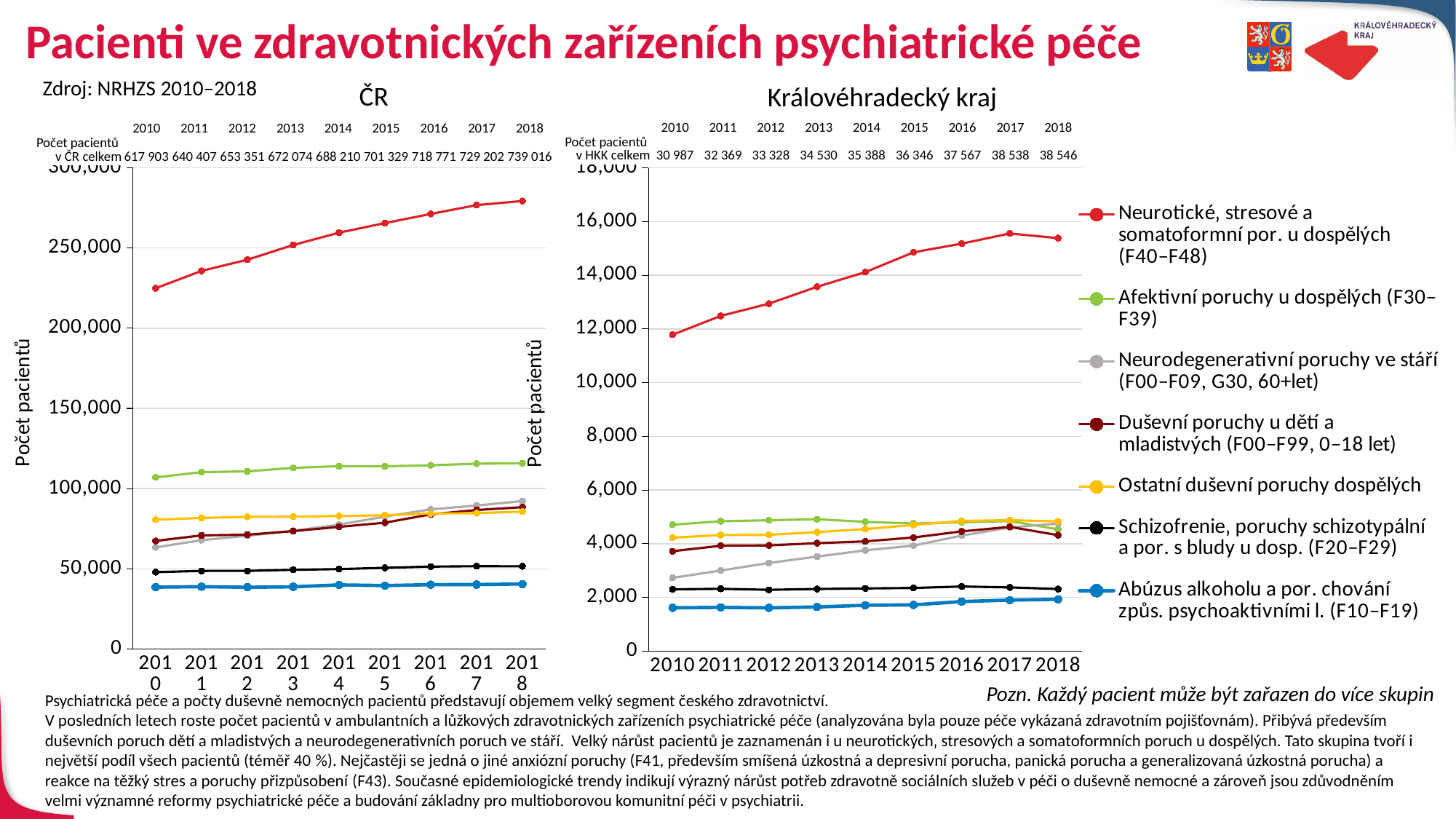
In the Královéhradecký kraj chart, which series has the lowest value in 2018? Abúzus alkoholu a por. chování způs. psychoaktivními l. (F10–F19) How many series does the legend list for the charts? 7 In the ČR chart, does the Neurotické, stresové a somatoformní por. u dospělých (F40–F48) series rise or fall from 2010 to 2018? rise In the Královéhradecký kraj chart, is the 2017 value for Neurotické, stresové a somatoformní por. u dospělých (F40–F48) greater or less than 14,000? greater In the Královéhradecký kraj chart, does the Neurodegenerativní poruchy ve stáří (F00–F09, G30, 60+let) series rise or fall from 2010 to 2018? rise In the Královéhradecký kraj chart, which series has the highest value in 2018? Neurotické, stresové a somatoformní por. u dospělých (F40–F48) What kind of chart is the ČR chart? line chart In the Královéhradecký kraj chart, which series is higher in 2010: Afektivní poruchy u dospělých (F30–F39) or Ostatní duševní poruchy dospělých? Afektivní poruchy u dospělých (F30–F39) In the ČR chart, is the 2010 value for Abúzus alkoholu a por. chování způs. psychoaktivními l. (F10–F19) greater or less than 50,000? less What is the title of the chart on the right side of the slide? Královéhradecký kraj In the ČR chart, is the 2018 value for Neurotické, stresové a somatoformní por. u dospělých (F40–F48) greater or less than 250,000? greater How many years are shown on the x axis of the Královéhradecký kraj chart? 9